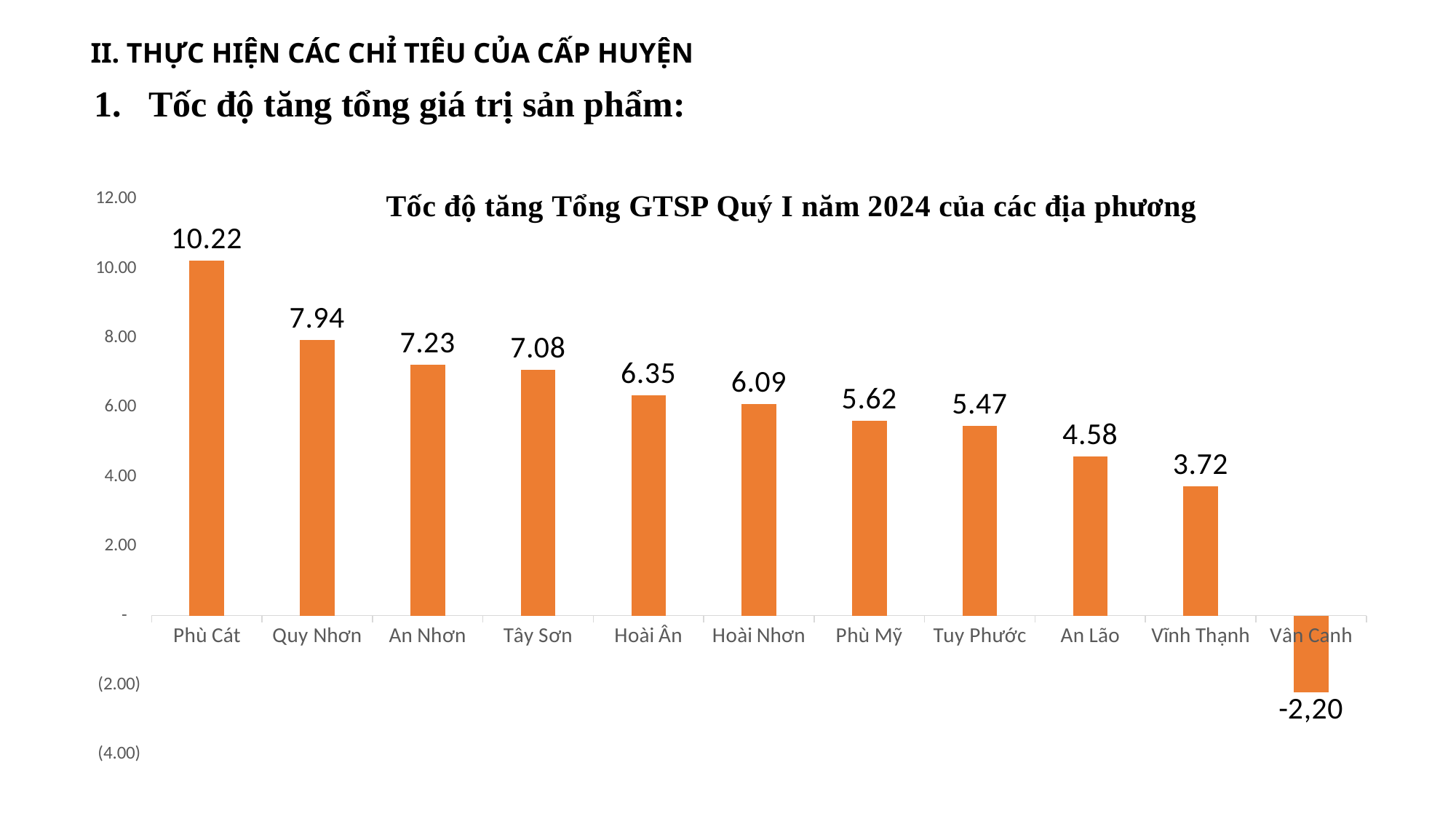
How many localities are shown on the chart? 11 What kind of chart is shown on the slide? bar chart What is the value for Phù Cát? 10.22 Which locality has the highest value? Phù Cát Do the values rise or fall from left to right along the x axis? fall Which is larger, the value for An Lão or the value for Vĩnh Thạnh? An Lão Which locality has the lowest value? Vân Canh What is the value for Vân Canh? -2,20 What is the value for Hoài Nhơn? 6.09 What is the difference between the values for Phù Cát and Quy Nhơn? 2.28 What is the title of the chart? Tốc độ tăng Tổng GTSP Quý I năm 2024 của các địa phương Is the value for Tây Sơn greater or less than 6.00? greater